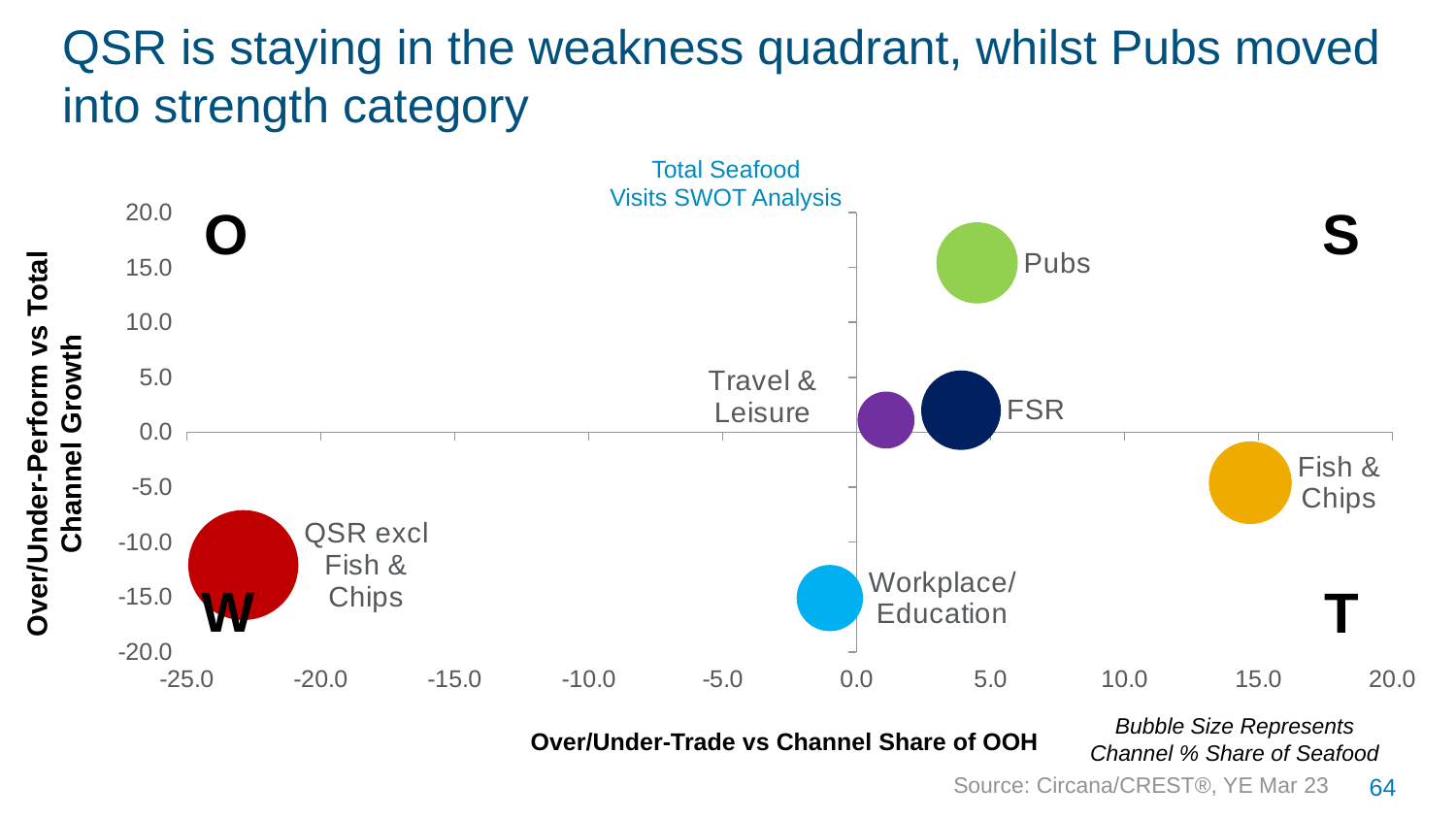
Which has the higher Over/Under-Perform vs Total Channel Growth value, Pubs or FSR? Pubs Which channel has the lowest Over/Under-Trade vs Channel Share of OOH value? QSR excl Fish & Chips According to the note on the slide, what does the bubble size represent? Channel % Share of Seafood Is the Over/Under-Perform vs Total Channel Growth value for Workplace/Education greater or less than -10.0? less Is the Over/Under-Trade vs Channel Share of OOH value for QSR excl Fish & Chips greater or less than -20.0? less What is the title of the chart? Total Seafood Visits SWOT Analysis Which channel has the highest Over/Under-Trade vs Channel Share of OOH value? Fish & Chips What kind of chart is shown on the slide? Bubble chart How many channel bubbles are plotted on the chart? 6 Is the Over/Under-Perform vs Total Channel Growth value for Pubs greater or less than 10.0? greater Which channel has the highest Over/Under-Perform vs Total Channel Growth value? Pubs